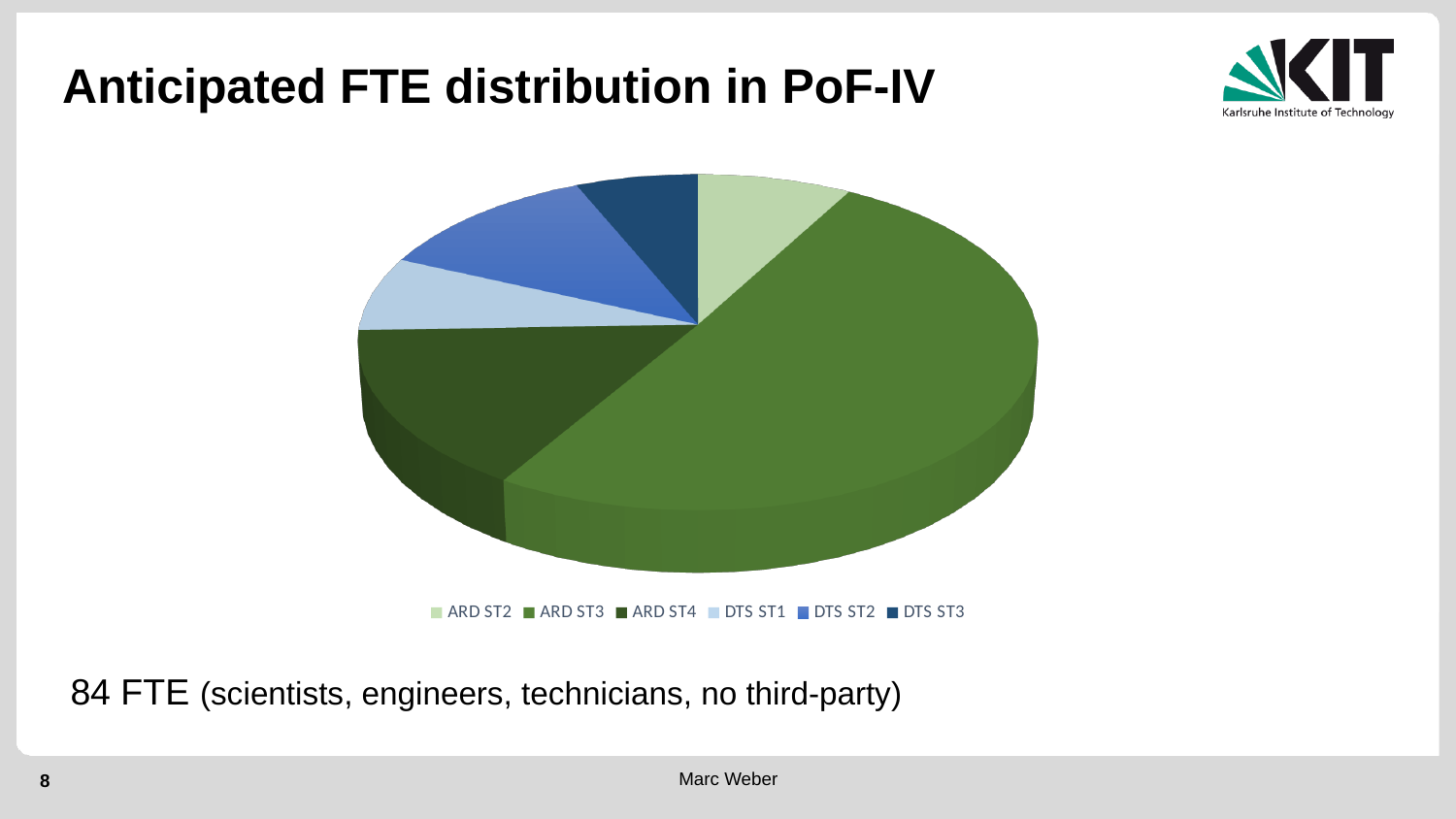
Which slice is larger, ARD ST4 or DTS ST2? ARD ST4 Which slice is larger, ARD ST3 or ARD ST4? ARD ST3 Which legend entry is shown in the lightest green colour? ARD ST2 Which slice is larger, ARD ST4 or ARD ST2? ARD ST4 How many slices does the pie chart have? 6 How many entries does the legend of the pie chart list? 6 Which category has the largest slice in the pie chart? ARD ST3 What is the title of the chart on the slide? Anticipated FTE distribution in PoF-IV What kind of chart is shown on the slide? pie chart